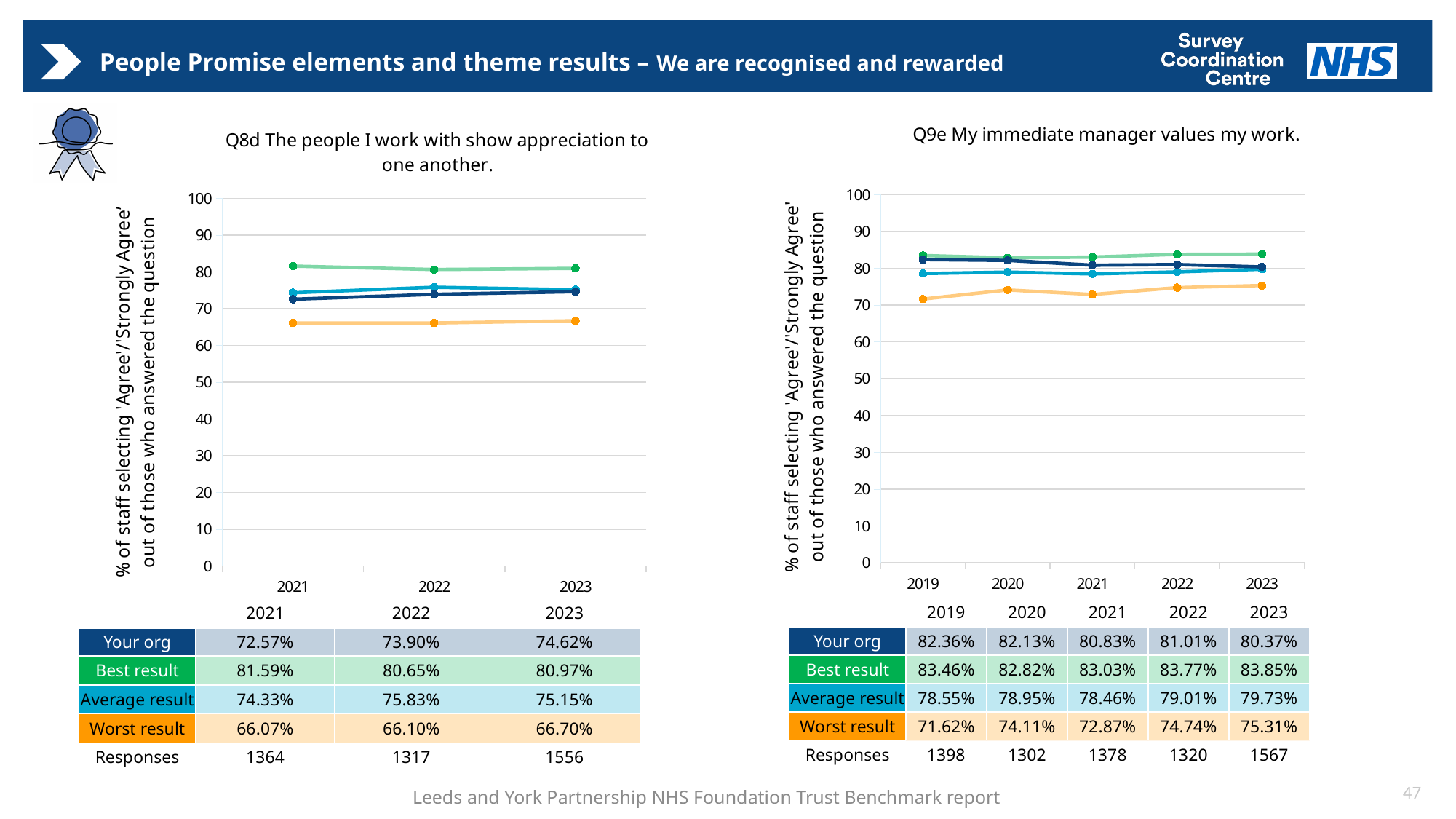
What kind of chart is used for Q9e (right)? Line chart In the Q8d chart (left), is the 'Worst result' value for 2022 greater or less than 70? less How many years are plotted on the x axis of the Q8d chart (left)? 3 How many series are shown in the Q9e chart (right)? 4 In the Q9e chart (right), what is the 'Worst result' value for 2019? 71.62% In the Q8d chart (left), does the 'Your org' value rise or fall from 2021 to 2023? Rise In the Q9e chart (right), in which year is the 'Best result' highest? 2023 In the Q8d chart (left), in which year is the 'Your org' value lowest? 2021 In the Q9e chart (right), what is the 'Average result' value for 2022? 79.01% In the Q8d chart (left), what is the difference between the 'Best result' and 'Your org' values in 2023? 6.35 percentage points In the Q9e chart (right), is the 'Your org' value larger in 2019 or in 2023? 2019 In the Q8d chart (left), what is the 'Your org' value for 2023? 74.62%